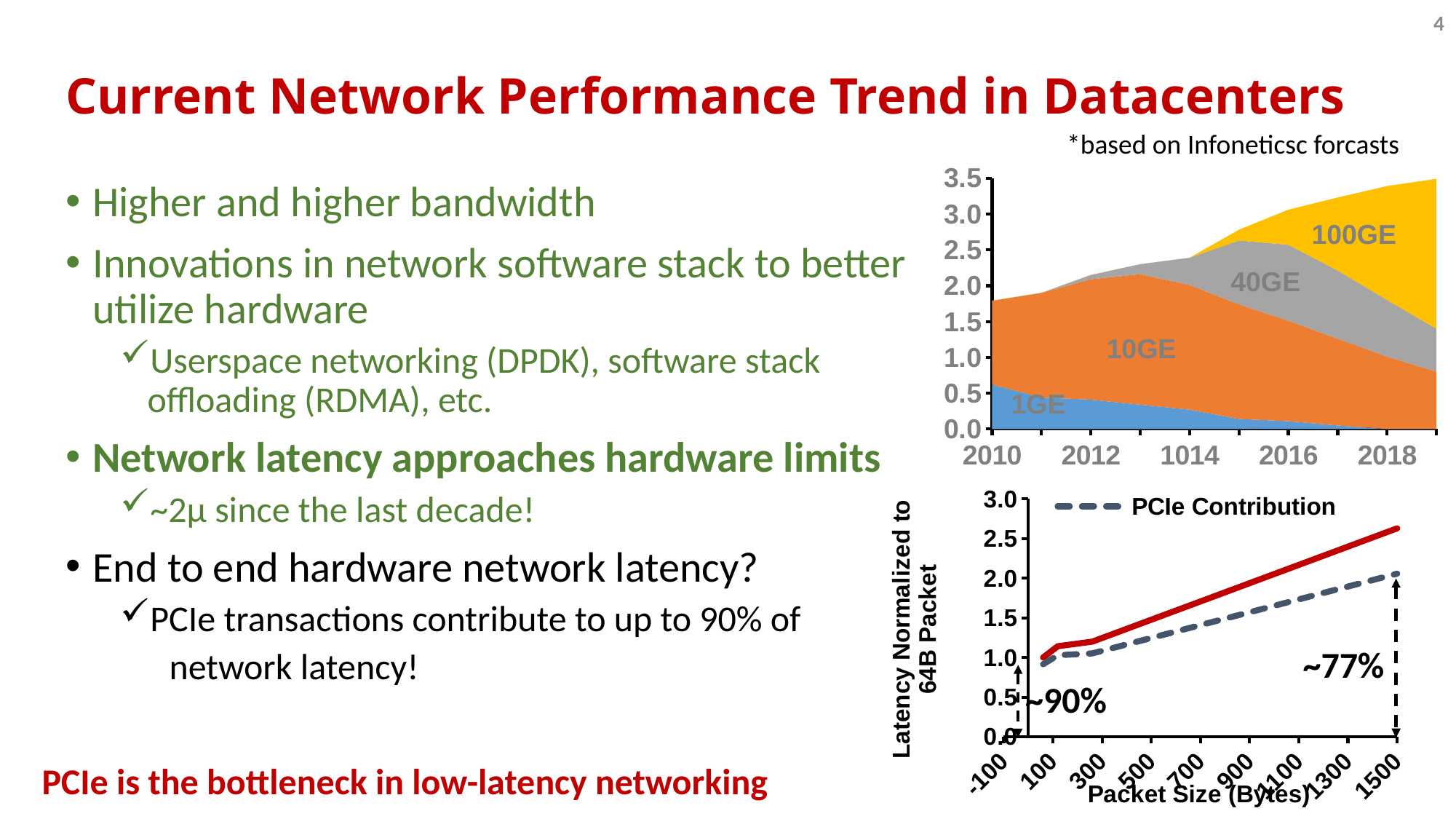
In the bottom chart, is the solid red line's value at packet size 1500 greater or less than 2.5? greater In the top chart, does the 100GE area rise or fall toward 2018? rise What kind of chart is the top chart showing 1GE, 10GE, 40GE and 100GE? stacked area chart What kind of chart is the bottom chart with the PCIe Contribution line? line chart In the top chart, is the total stacked value in 2010 greater or less than 2.0? less In the top chart, which is larger in 2018: the 100GE area or the 1GE area? 100GE In the top chart, how many network speed series (1GE, 10GE, 40GE, 100GE) are plotted? 4 In the top chart, which series is drawn at the bottom of the stack? 1GE In the top chart, is the total stacked value in 2018 greater or less than 3.0? greater In the bottom chart, does the solid red line rise or fall as packet size increases? rise In the top chart, does the 1GE area rise or fall from 2010 to 2018? fall In the bottom chart, how many series does the legend list? 1